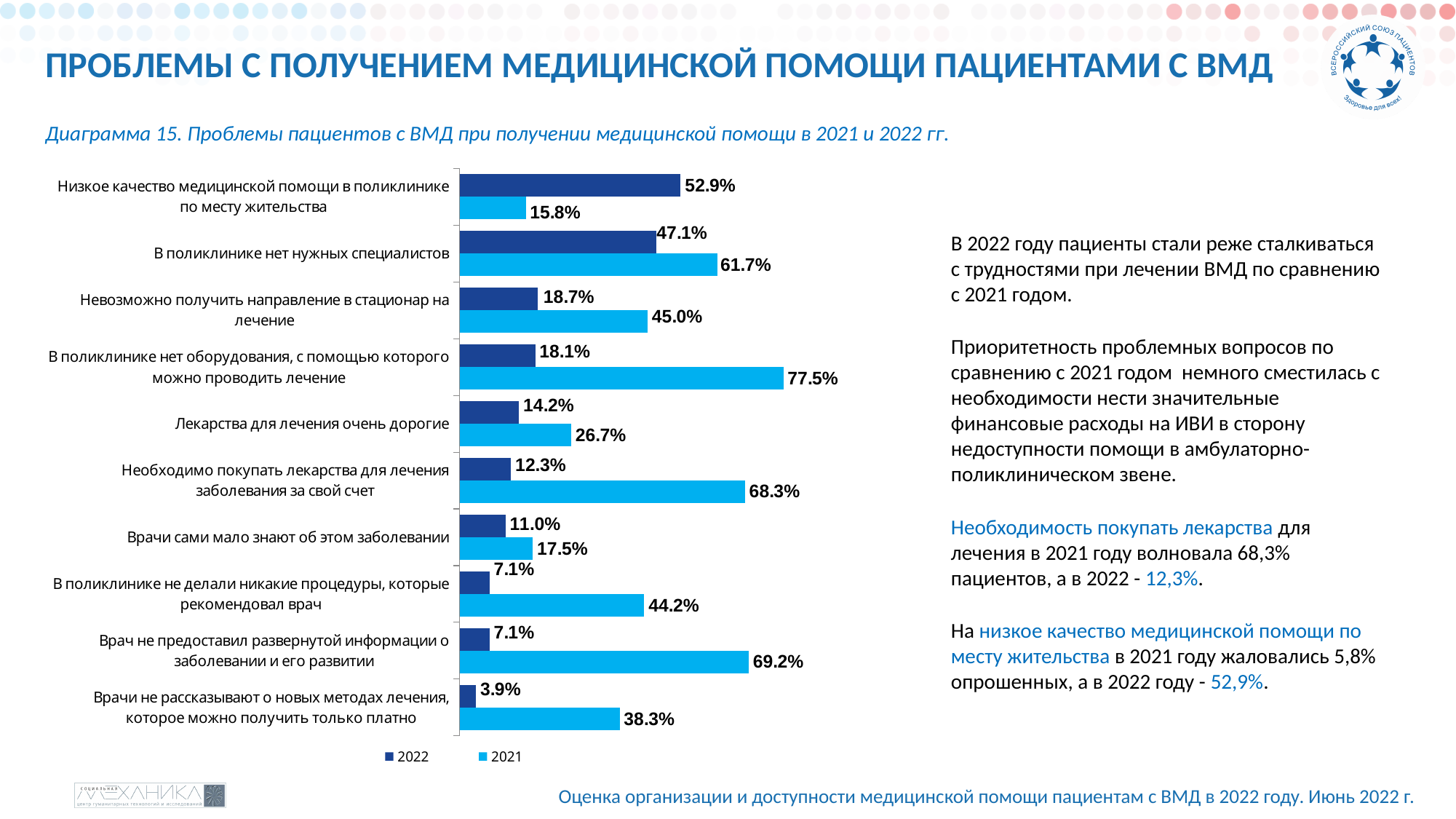
Which category has the lowest 2021 value? Низкое качество медицинской помощи в поликлинике по месту жительства What is the 2021 value for "Врачи не рассказывают о новых методах лечения, которое можно получить только платно"? 38.3% Which category has the lowest 2022 value? Врачи не рассказывают о новых методах лечения, которое можно получить только платно What is the 2022 value for "Низкое качество медицинской помощи в поликлинике по месту жительства"? 52.9% Which colour represents the 2022 series in the chart? dark blue Which category has the highest 2021 value? В поликлинике нет оборудования, с помощью которого можно проводить лечение How many problem categories are plotted in the chart? 10 How many series does the chart legend list? 2 What is the 2021 value for "В поликлинике нет оборудования, с помощью которого можно проводить лечение"? 77.5% For "В поликлинике нет нужных специалистов", which year has the larger value, 2021 or 2022? 2021 What is the difference between the 2021 and 2022 values for "Необходимо покупать лекарства для лечения заболевания за свой счет"? 56.0 percentage points What type of chart is shown on the slide? bar chart